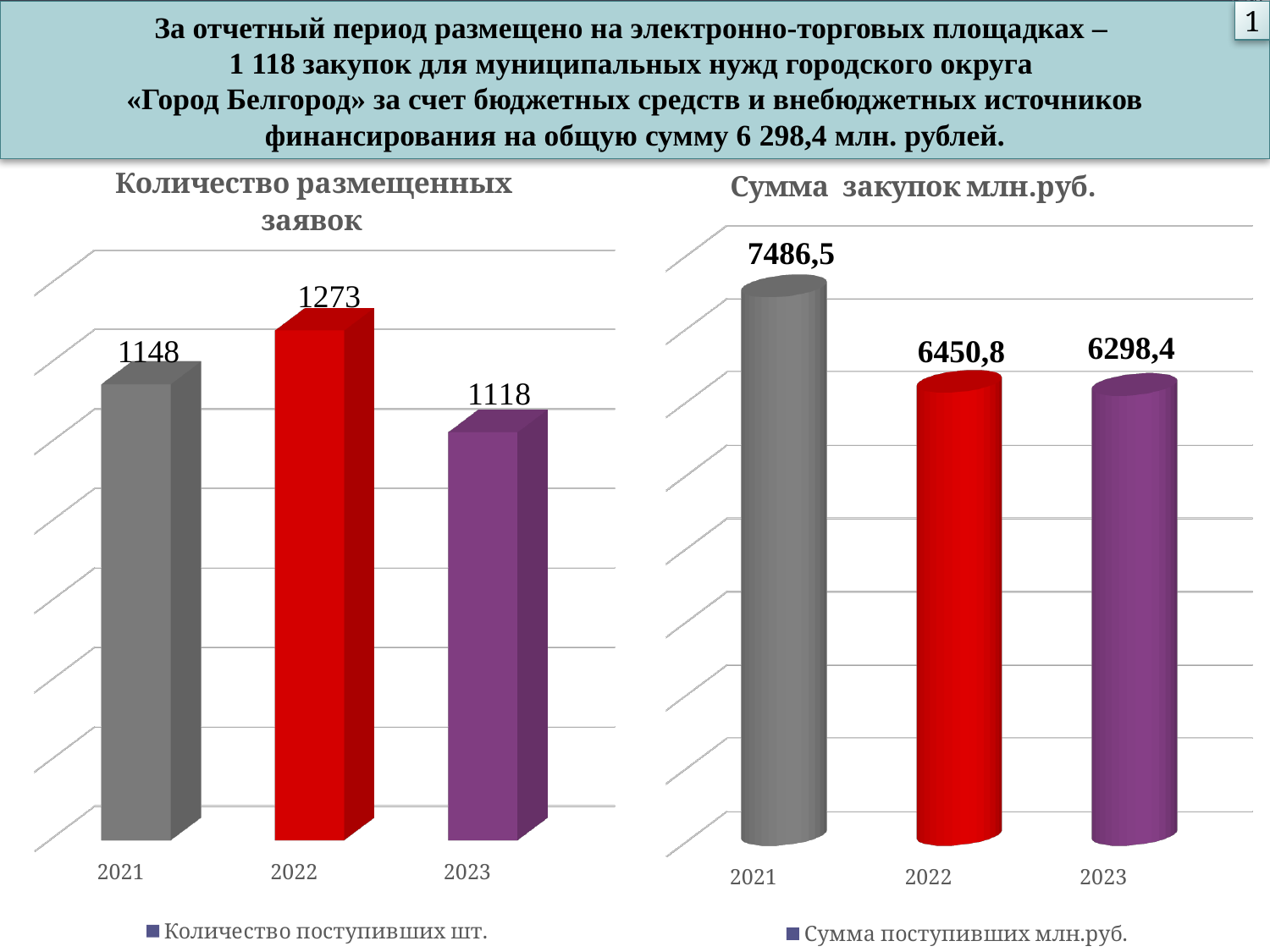
In the chart 'Сумма закупок млн.руб.', which is larger: the value for 2022 or the value for 2023? 2022 In the chart 'Сумма закупок млн.руб.', what is the value for 2021? 7486,5 In the chart 'Количество размещенных заявок', which year has the lowest value? 2023 How many years are shown in the chart 'Количество размещенных заявок'? 3 In the chart 'Количество размещенных заявок', which year has the highest value? 2022 In the chart 'Сумма закупок млн.руб.', what is the difference between the values for 2021 and 2022? 1035,7 In the chart 'Сумма закупок млн.руб.', which year has the highest value? 2021 In the chart 'Сумма закупок млн.руб.', what is the value for 2023? 6298,4 In the chart 'Количество размещенных заявок', what is the value for 2022? 1273 What kind of chart is the chart 'Сумма закупок млн.руб.'? bar chart In the chart 'Количество размещенных заявок', what is the difference between the values for 2022 and 2021? 125 In the chart 'Сумма закупок млн.руб.', do the values rise or fall from 2021 to 2023? fall